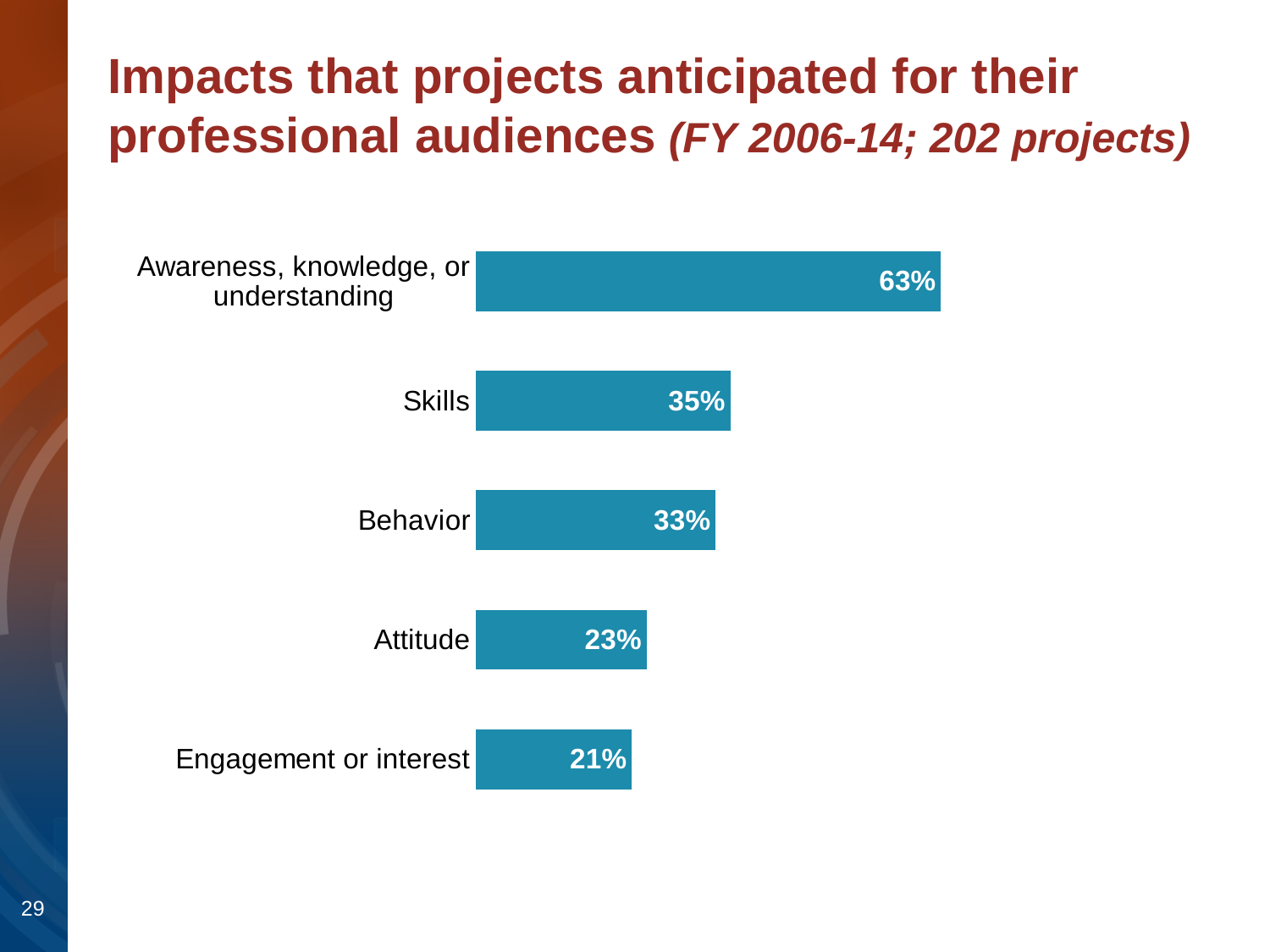
What is the value shown for Engagement or interest? 21% What percentage of projects anticipated impacts on awareness, knowledge, or understanding for their professional audiences? 63% Which has a larger value, Skills or Behavior? Skills What is the difference between the values for Awareness, knowledge, or understanding and Skills? 28% What is the difference between the values for Attitude and Engagement or interest? 2% Which impact category has the lowest value? Engagement or interest How many impact categories are shown in the chart? 5 What is the value shown for Skills? 35% What kind of chart is shown on the slide? Bar chart Which impact category has the highest value? Awareness, knowledge, or understanding What is the value shown for Behavior? 33% What is the value shown for Attitude? 23%